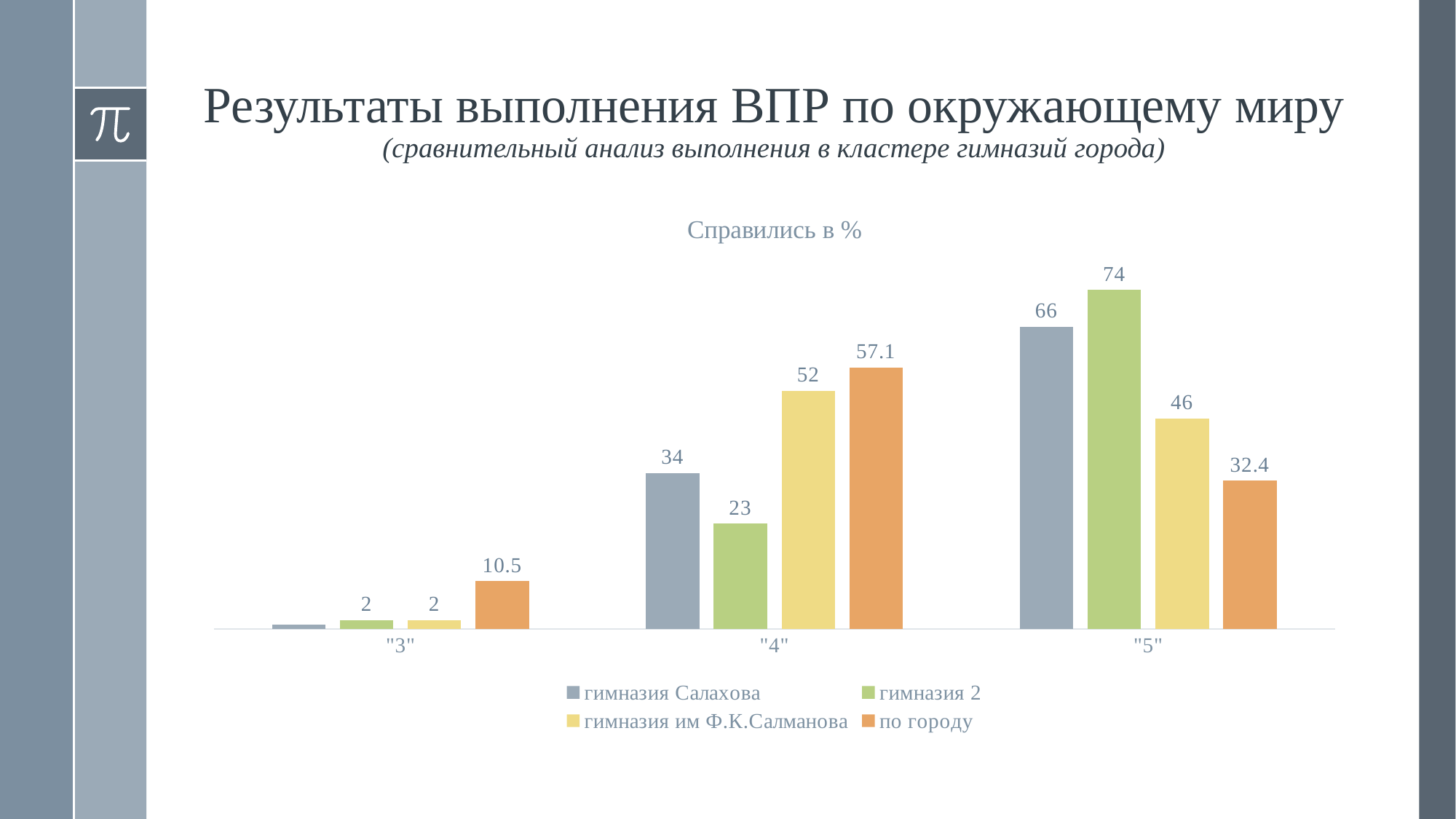
Which is larger in the "4" category: гимназия Салахова or гимназия 2? гимназия Салахова What is the value for гимназия 2 in the "5" category? 74 Which series has the lowest value in the "4" category? гимназия 2 How many series does the legend list? 4 What is the difference between по городу and гимназия им Ф.К.Салманова in the "4" category? 5.1 What is the difference between гимназия 2 and гимназия Салахова in the "5" category? 8 Which series has the highest value in the "5" category? гимназия 2 What is the value for гимназия им Ф.К.Салманова in the "4" category? 52 What is the value for по городу in the "3" category? 10.5 What type of chart is shown on the slide? bar chart What is the value for по городу in the "4" category? 57.1 How many categories are shown on the x axis? 3